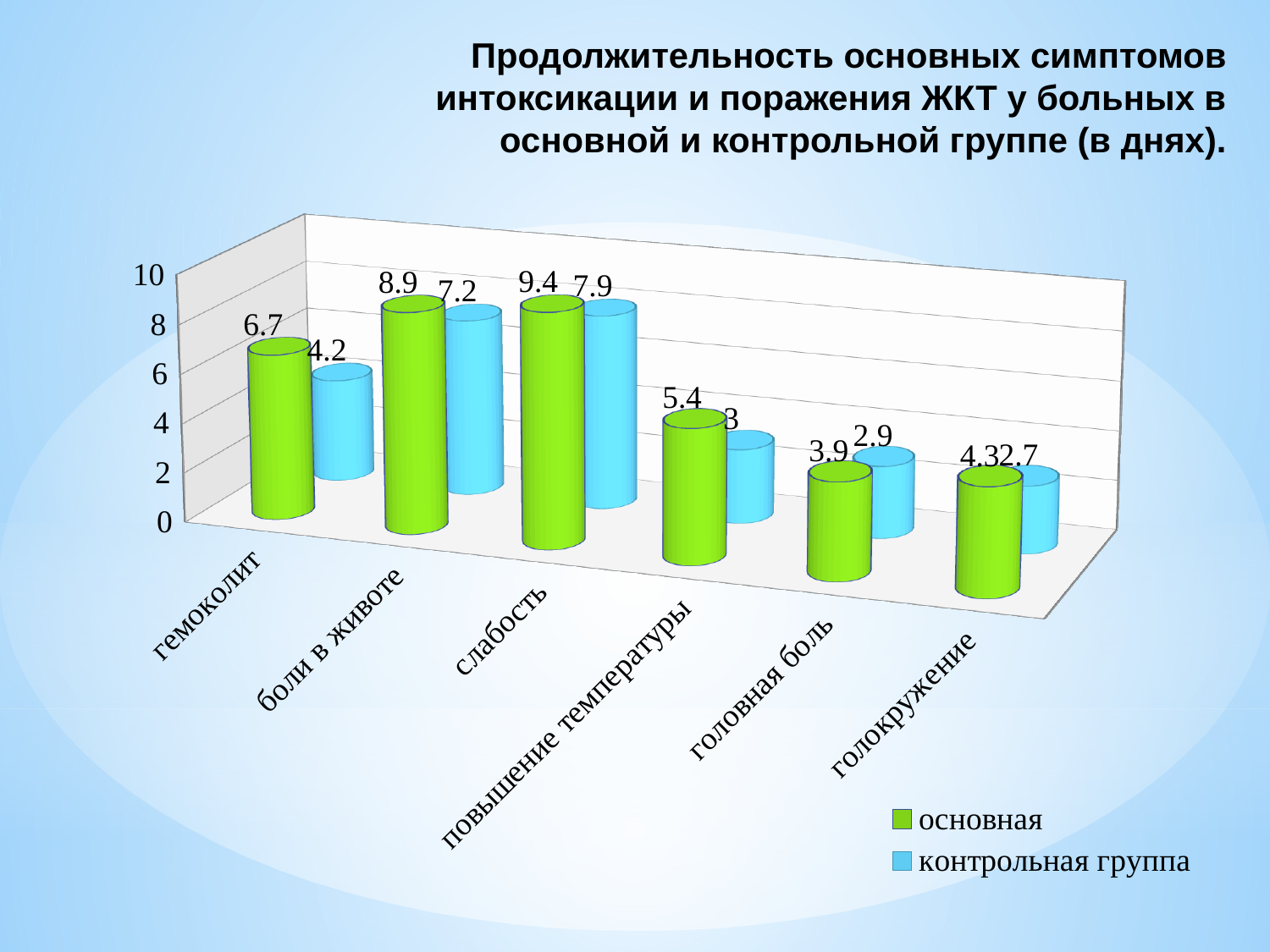
What is the value for контрольная группа for головная боль? 2.9 Which category has the highest value for основная? слабость What is the value for контрольная группа for гемоколит? 4.2 Which category has the lowest value for основная? головная боль Which colour represents контрольная группа in the legend? blue How many series does the legend list? 2 What is the difference between основная and контрольная группа for гемоколит? 2.5 Which is larger for повышение температуры: основная or контрольная группа? основная What kind of chart is this? bar chart What is the value for основная for слабость? 9.4 What is the value for основная for боли в животе? 8.9 How many categories are shown on the x axis? 6